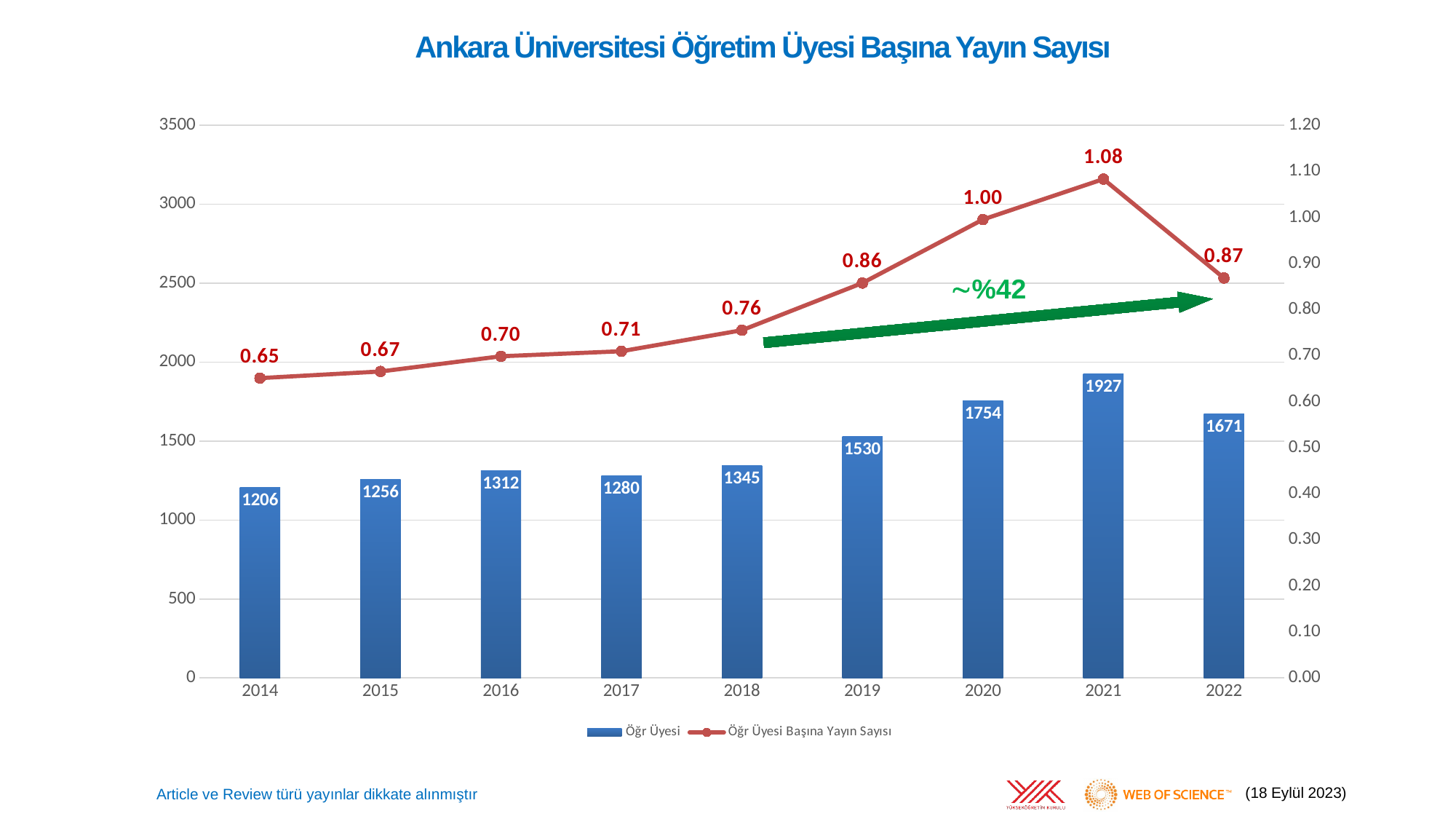
What is the title of the chart? Ankara Üniversitesi Öğretim Üyesi Başına Yayın Sayısı Which is larger, the Öğr Üyesi value for 2016 or for 2017? 2016 What kind of chart is used for the Öğr Üyesi series? bar chart What is the value of Öğr Üyesi for 2014? 1206 What is the value of Öğr Üyesi for 2022? 1671 How many series does the legend list? 2 What is the value of Öğr Üyesi Başına Yayın Sayısı for 2020? 1.00 Which year has the lowest Öğr Üyesi Başına Yayın Sayısı value? 2014 Which year has the highest Öğr Üyesi value? 2021 How many years are shown on the x axis? 9 Is the Öğr Üyesi value for 2019 greater or less than 1500? greater What is the difference between the Öğr Üyesi values for 2021 and 2022? 256